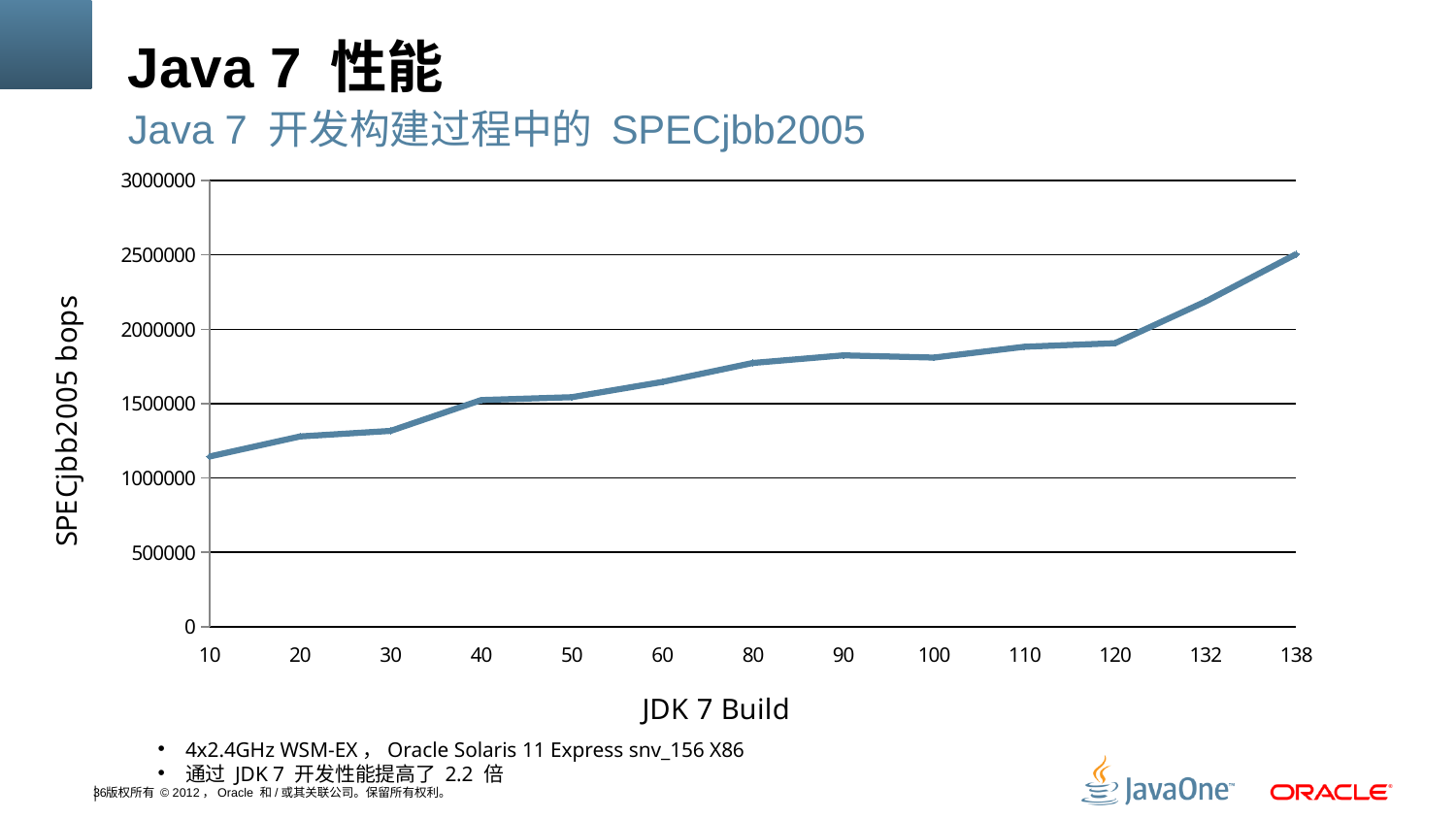
Is the value for build 80 greater or less than 1500000? greater How many JDK 7 Build points are plotted along the x axis? 13 Which JDK 7 Build has the lowest SPECjbb2005 bops value? 10 Which has the larger SPECjbb2005 bops value, build 20 or build 40? 40 Which JDK 7 Build has the highest SPECjbb2005 bops value? 138 Do the SPECjbb2005 bops values generally rise or fall as the JDK 7 Build number increases? rise What is the title of the y axis? SPECjbb2005 bops Is the value for build 10 greater or less than 1500000? less What kind of chart is shown on the slide? line chart What is the title of the x axis? JDK 7 Build Is the value for build 120 greater or less than 2000000? less